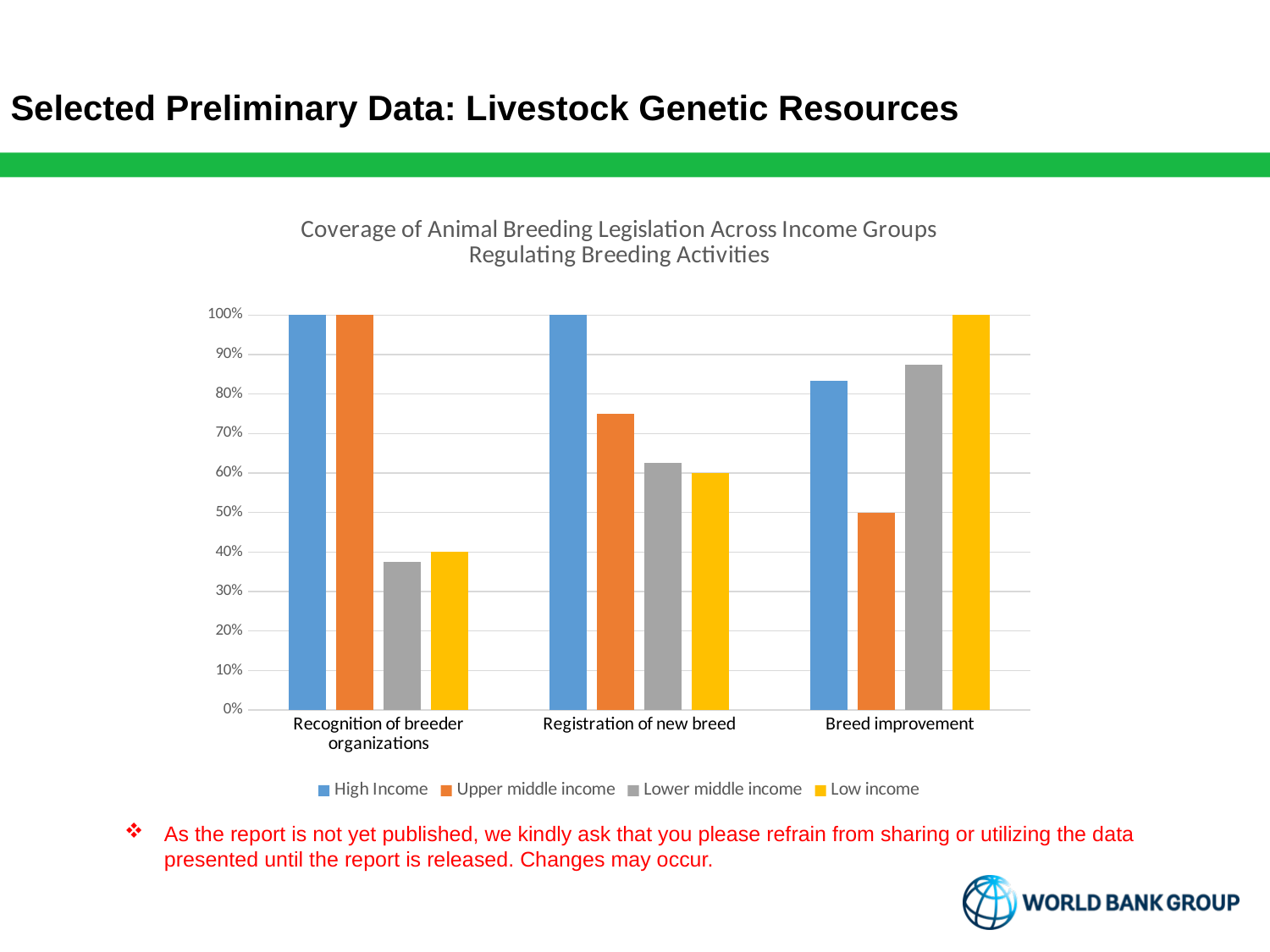
How many categories are shown on the x axis? 3 How many series does the legend list? 4 Is the value for Lower middle income in the Recognition of breeder organizations category greater or less than 40%? less Which is larger in the Registration of new breed category: Upper middle income or Lower middle income? Upper middle income What is the value for Upper middle income in the Breed improvement category? 50% Which income group has the lowest value in the Breed improvement category? Upper middle income What is the value for High Income in the Registration of new breed category? 100% Which income group has the highest value in the Breed improvement category? Low income What is the value for Low income in the Registration of new breed category? 60% What is the value for Low income in the Recognition of breeder organizations category? 40% What kind of chart is shown on the slide? Bar chart What is the difference between the Low income values for Registration of new breed and Recognition of breeder organizations? 20%